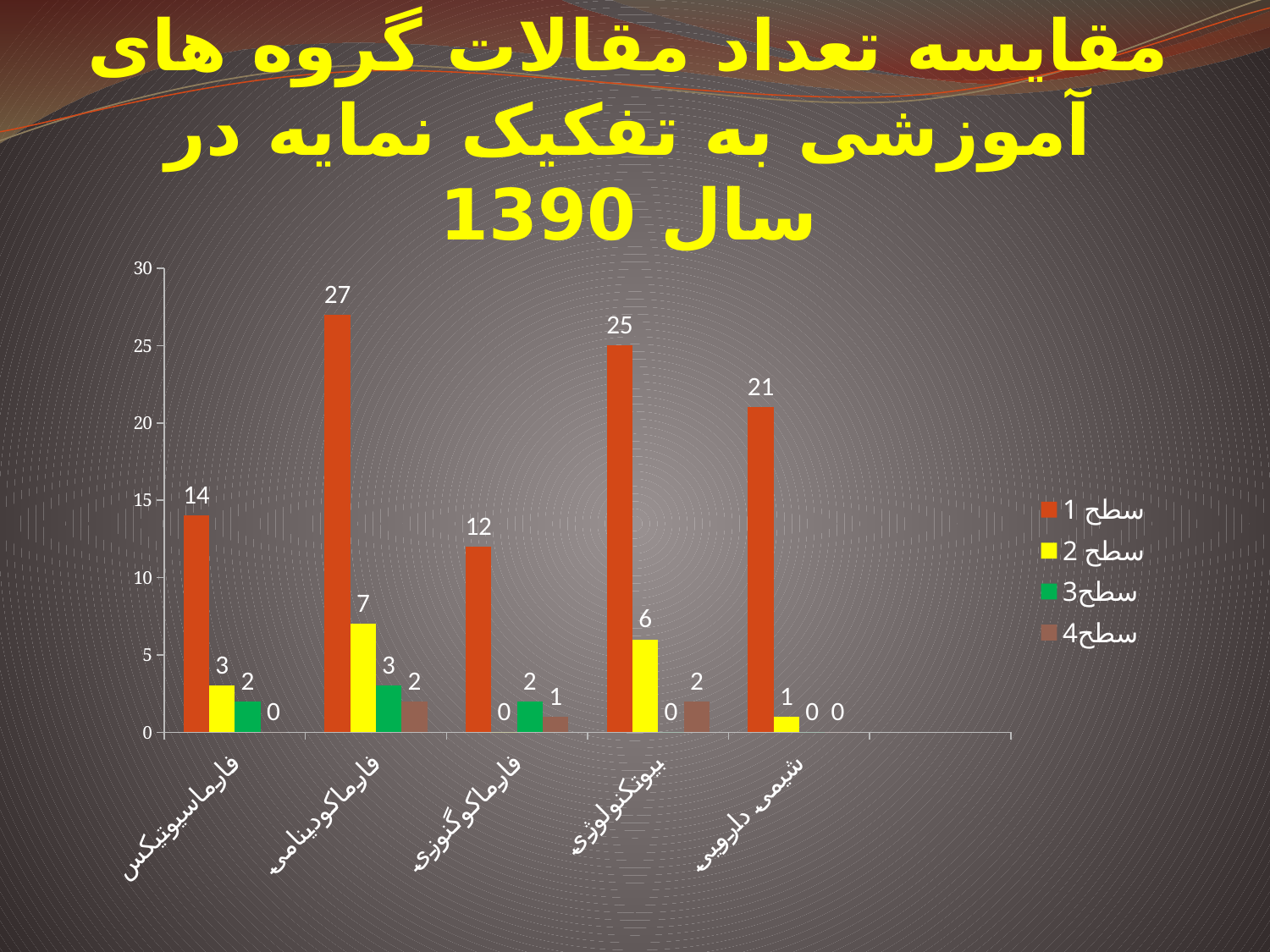
How many series does the legend list? 4 Is the سطح 1 value for بیوتکنولوژی greater or less than 20? greater What is the value of سطح 2 for بیوتکنولوژی? 6 What is the value of سطح4 for فارماکوگنوزی? 1 What is the value of سطح 1 for فارماکودینامی? 27 What is the difference between the سطح 1 values for فارماکودینامی and شیمی دارویی? 6 Which is larger: the سطح 2 value for فارماکودینامی or for بیوتکنولوژی? فارماکودینامی Which category has the lowest سطح 1 value? فارماکوگنوزی What is the total of all four series for فارماسیوتیکس? 19 What kind of chart is shown on the slide? bar chart How many categories are shown on the x axis? 5 Which category has the highest سطح 1 value? فارماکودینامی